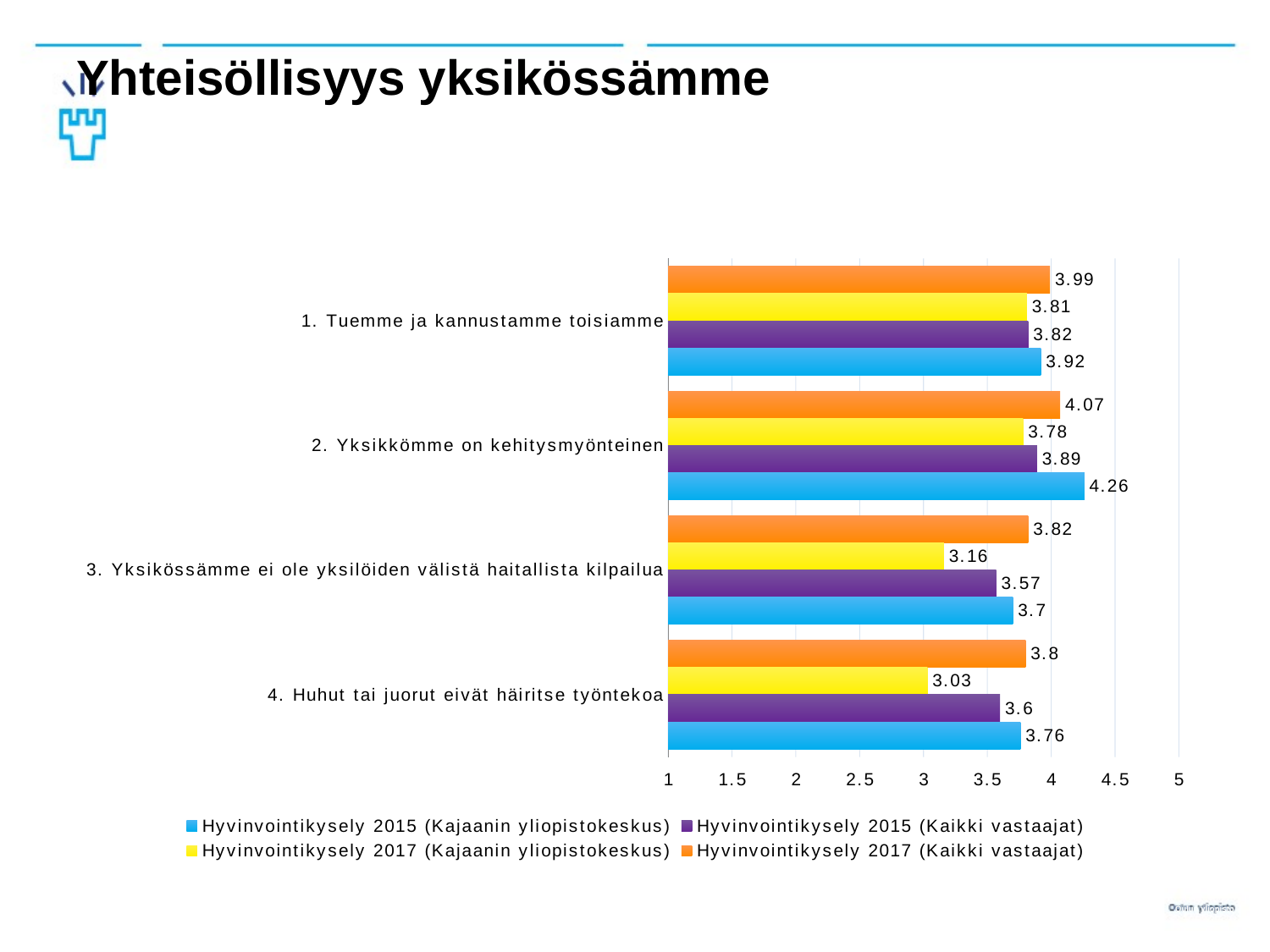
What is the difference between the Hyvinvointikysely 2017 (Kaikki vastaajat) and Hyvinvointikysely 2017 (Kajaanin yliopistokeskus) values for "4. Huhut tai juorut eivät häiritse työntekoa"? 0.77 How many categories are shown on the chart? 4 Is the Hyvinvointikysely 2017 (Kajaanin yliopistokeskus) value for "3. Yksikössämme ei ole yksilöiden välistä haitallista kilpailua" greater or less than 3.5? less What is the value for "2. Yksikkömme on kehitysmyönteinen" in the Hyvinvointikysely 2015 (Kajaanin yliopistokeskus) series? 4.26 What is the value for "1. Tuemme ja kannustamme toisiamme" in the Hyvinvointikysely 2017 (Kaikki vastaajat) series? 3.99 Which category has the highest value in the Hyvinvointikysely 2017 (Kajaanin yliopistokeskus) series? 1. Tuemme ja kannustamme toisiamme Which category has the lowest value in the Hyvinvointikysely 2015 (Kajaanin yliopistokeskus) series? 3. Yksikössämme ei ole yksilöiden välistä haitallista kilpailua What kind of chart is shown on the slide? Bar chart What is the value for "3. Yksikössämme ei ole yksilöiden välistä haitallista kilpailua" in the Hyvinvointikysely 2015 (Kaikki vastaajat) series? 3.57 What is the value for "4. Huhut tai juorut eivät häiritse työntekoa" in the Hyvinvointikysely 2017 (Kajaanin yliopistokeskus) series? 3.03 For "2. Yksikkömme on kehitysmyönteinen", which is larger: the Hyvinvointikysely 2015 (Kajaanin yliopistokeskus) value or the Hyvinvointikysely 2017 (Kaikki vastaajat) value? Hyvinvointikysely 2015 (Kajaanin yliopistokeskus) How many series does the legend list? 4